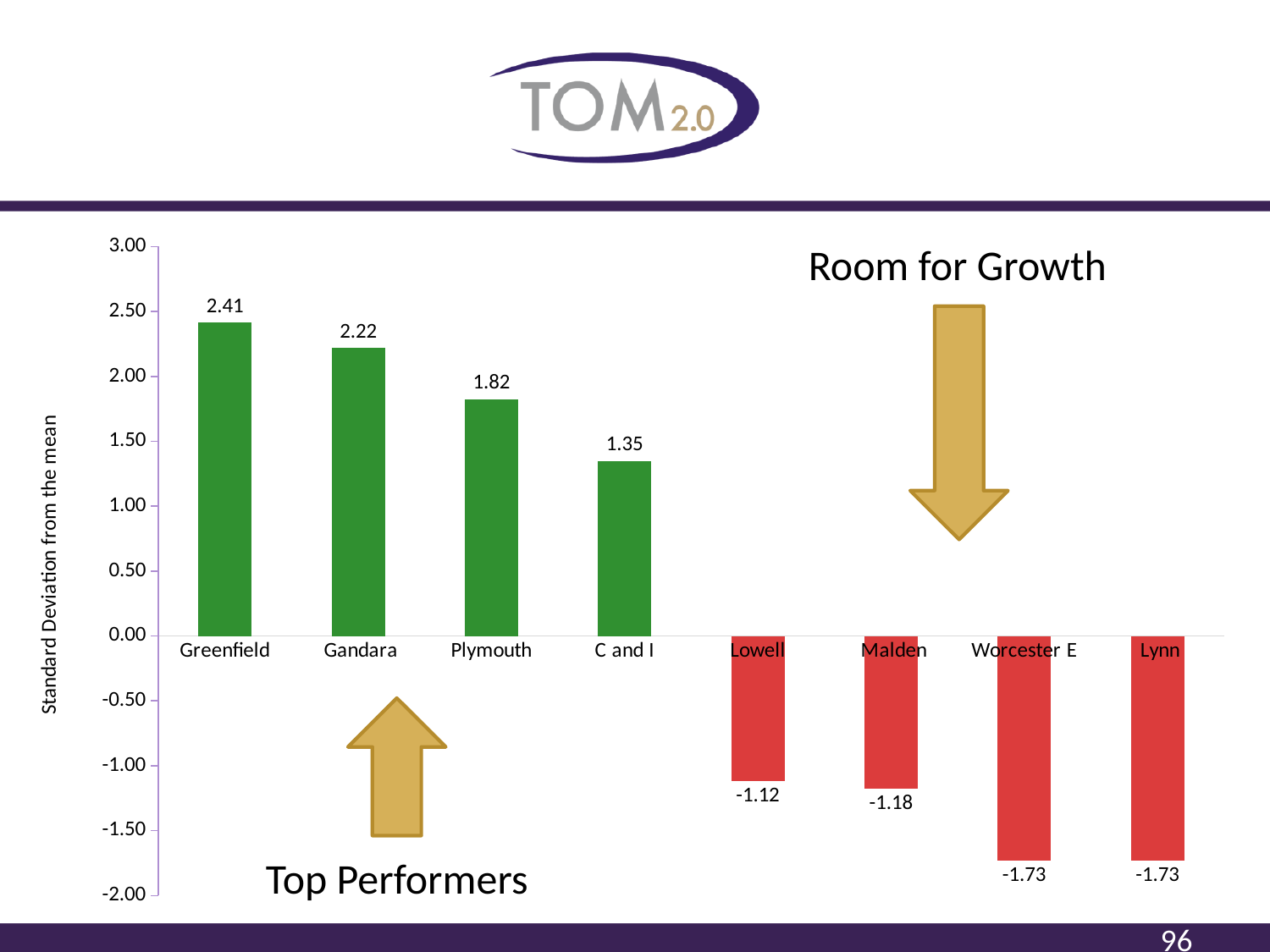
How many categories are shown on the chart? 8 What is the difference between the values for Plymouth and C and I? 0.47 What is the label of the vertical axis? Standard Deviation from the mean Which category has the highest value? Greenfield Is the value for C and I greater or less than 1.50? less What is the value for Lowell? -1.12 What is the value for Malden? -1.18 What kind of chart is shown on the slide? bar chart What is the value for Plymouth? 1.82 Which is larger, the value for Gandara or the value for Plymouth? Gandara What is the value for Greenfield? 2.41 What is the difference between the values for Greenfield and Gandara? 0.19